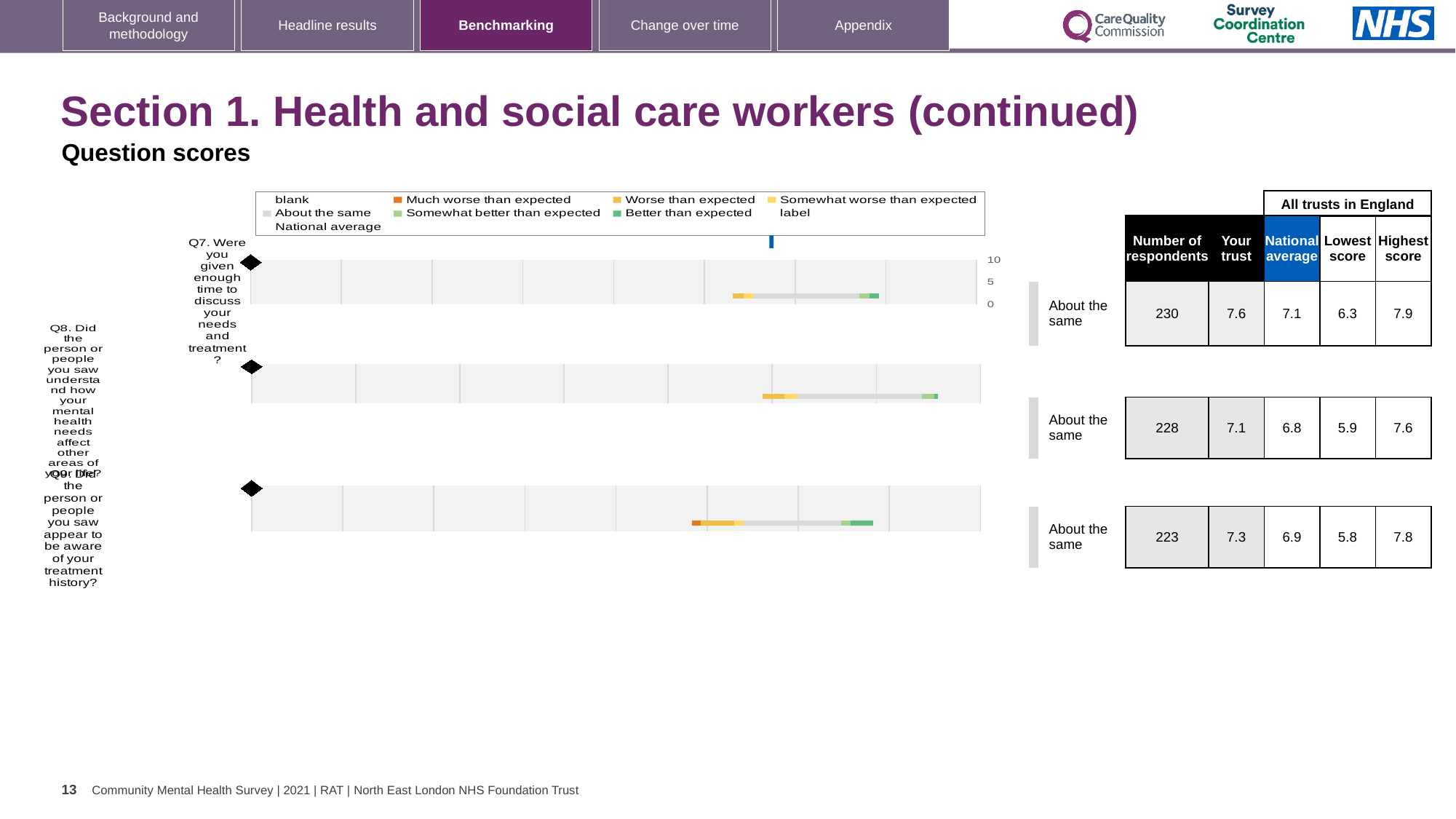
For Q7, what is the 'Your trust' score? 7.6 Which question has the highest 'Your trust' score? Q7 Which question has the lowest number of respondents? Q9 In the legend, what colour represents 'Much worse than expected'? orange For Q9 (awareness of treatment history), what is the lowest score among all trusts in England? 5.8 What kind of chart is used to show the question scores on this slide? bar chart For Q8 (understanding how mental health needs affect other areas of life), what is the national average score? 6.8 For Q9, is the 'Your trust' score larger or smaller than the national average? larger What benchmark category is shown for Q8? About the same How many questions (Q7, Q8, Q9) are plotted on this slide? 3 For Q7 (time to discuss needs and treatment), what is the number of respondents shown in the table? 230 For Q7, what is the difference between the 'Your trust' score and the national average? 0.5